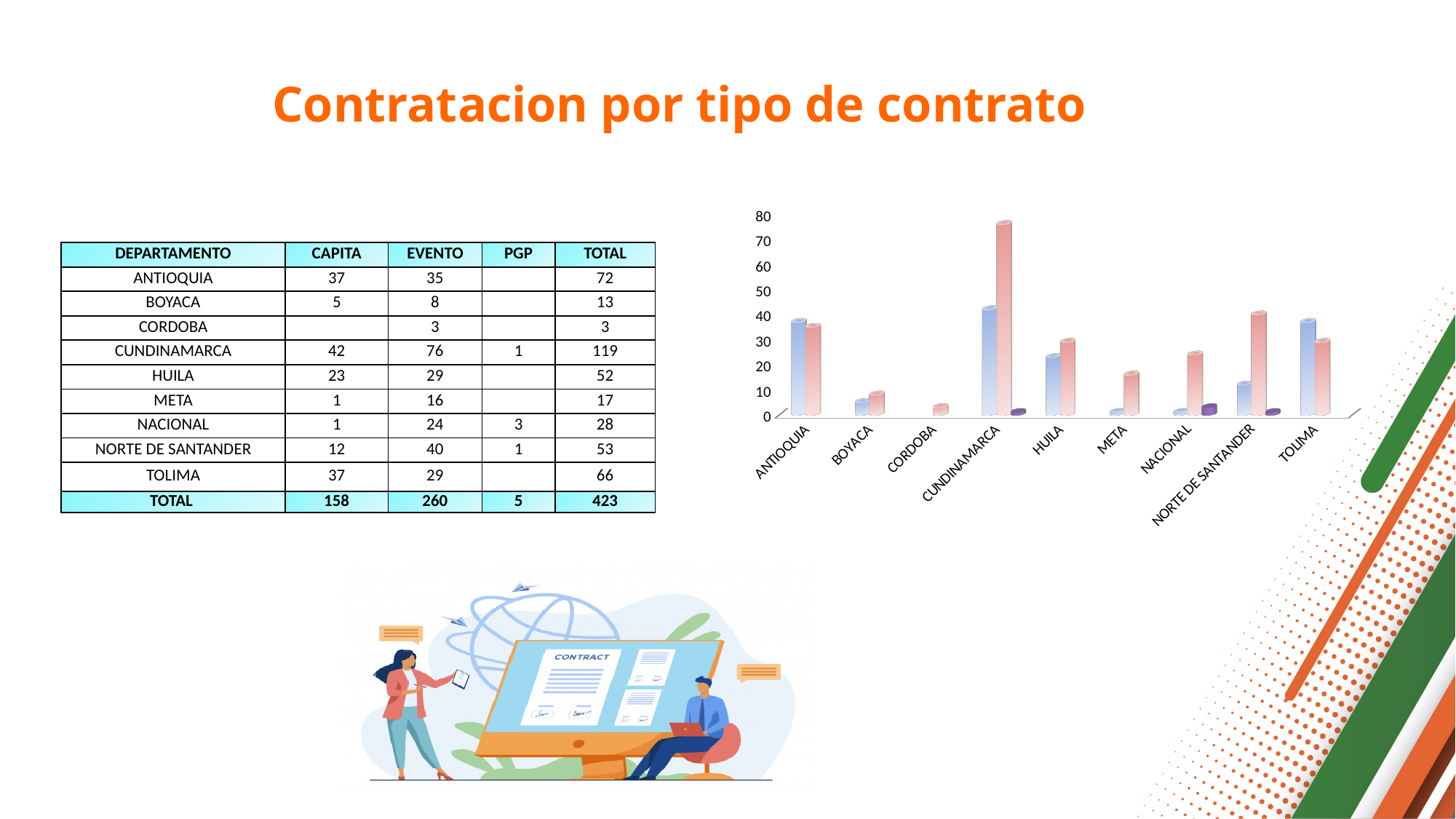
Which category has the shortest pink bar in the chart? CORDOBA Is the pink bar for CUNDINAMARCA greater or less than 70? greater Is the blue bar for ANTIOQUIA greater or less than 30? greater What is the highest value shown on the chart's vertical axis? 80 What kind of chart is shown on the slide? bar chart For NORTE DE SANTANDER, which bar is taller, the blue one or the pink one? the pink one Which category has the tallest bar in the chart? CUNDINAMARCA Is the pink bar for NORTE DE SANTANDER greater or less than 30? greater How many departments (categories) are shown along the x axis of the chart? 9 Which category has the tallest blue bar in the chart? CUNDINAMARCA For TOLIMA, which bar is taller, the blue one or the pink one? the blue one